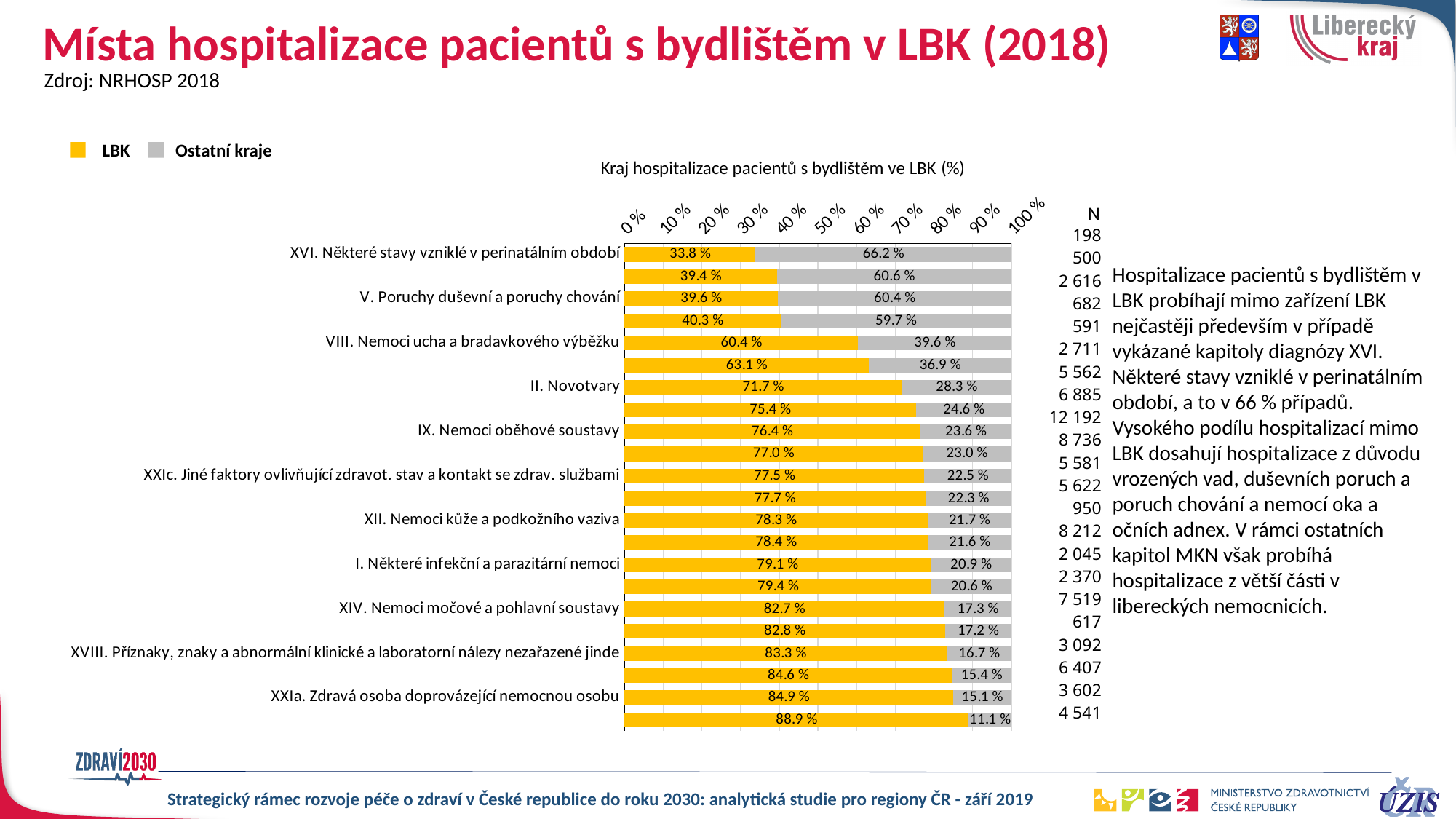
What is the highest LBK value shown in the chart? 88.9 % What is the Ostatní kraje value for VIII. Nemoci ucha a bradavkového výběžku? 39.6 % Which has a larger LBK value: IX. Nemoci oběhové soustavy or XII. Nemoci kůže a podkožního vaziva? XII. Nemoci kůže a podkožního vaziva How many bars does the chart contain? 22 What is the LBK value for II. Novotvary? 71.7 % What is the title of the chart? Kraj hospitalizace pacientů s bydlištěm ve LBK (%) What is the difference between the LBK and Ostatní kraje values for II. Novotvary? 43.4 % What is the LBK value for XIV. Nemoci močové a pohlavní soustavy? 82.7 % What is the Ostatní kraje value for XVI. Některé stavy vzniklé v perinatálním období? 66.2 % What kind of chart is shown on the slide? Stacked bar chart Which category has the lowest LBK value? XVI. Některé stavy vzniklé v perinatálním období How many series does the legend list? 2